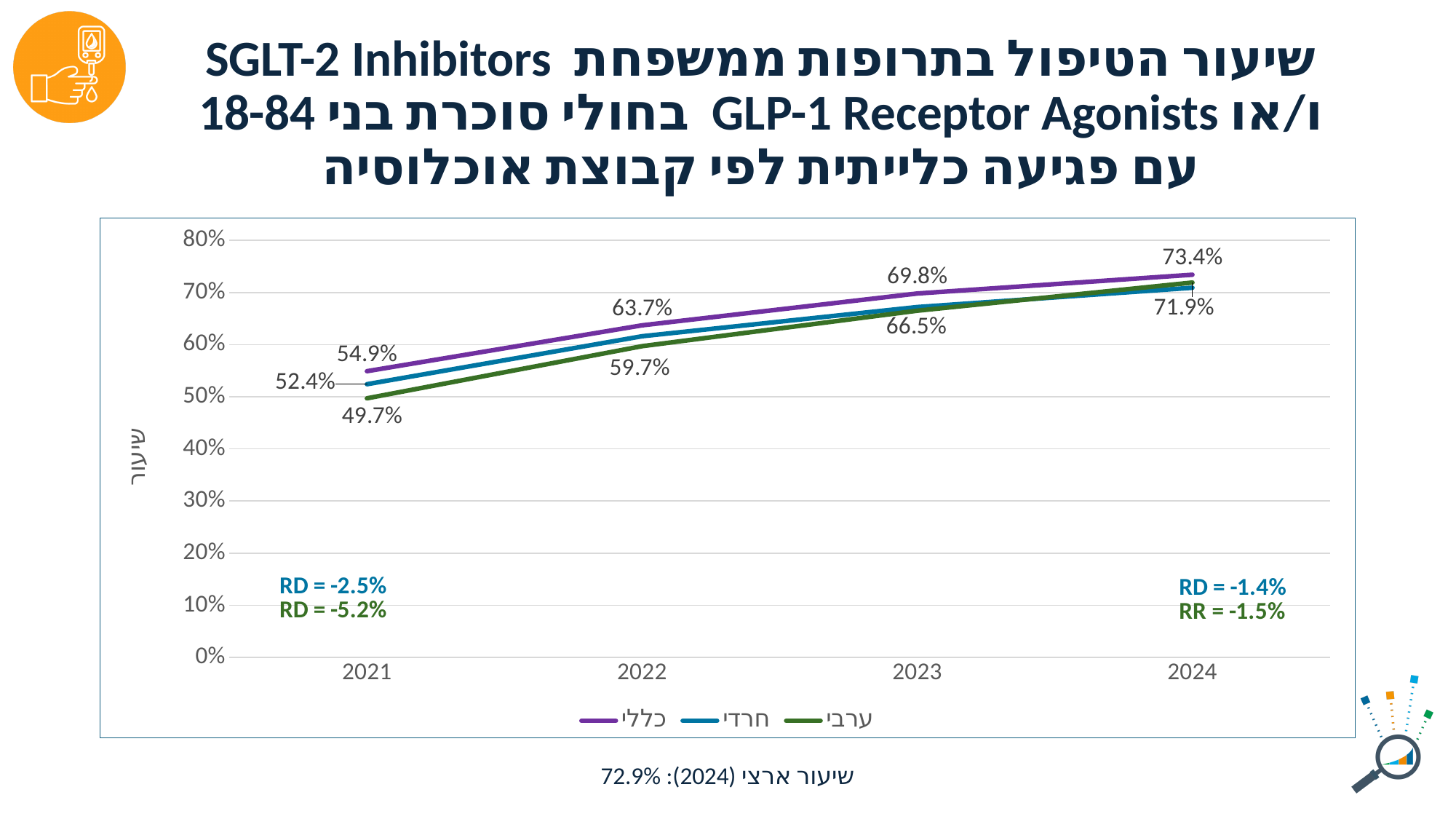
What is the difference between the כללי and ערבי values in 2021? 5.2 percentage points What is the value for חרדי in 2021? 52.4% Is the value for חרדי in 2023 greater or less than 60%? greater What is the value for כללי in 2021? 54.9% What is the value for ערבי in 2022? 59.7% How many years are shown on the x axis? 4 What is the value for כללי in 2024? 73.4% What is the value for ערבי in 2021? 49.7% What kind of chart is shown on the slide? line chart Do the values for כללי rise or fall from 2021 to 2024? rise How many series does the legend list? 3 Which series has the lowest value in 2021? ערבי